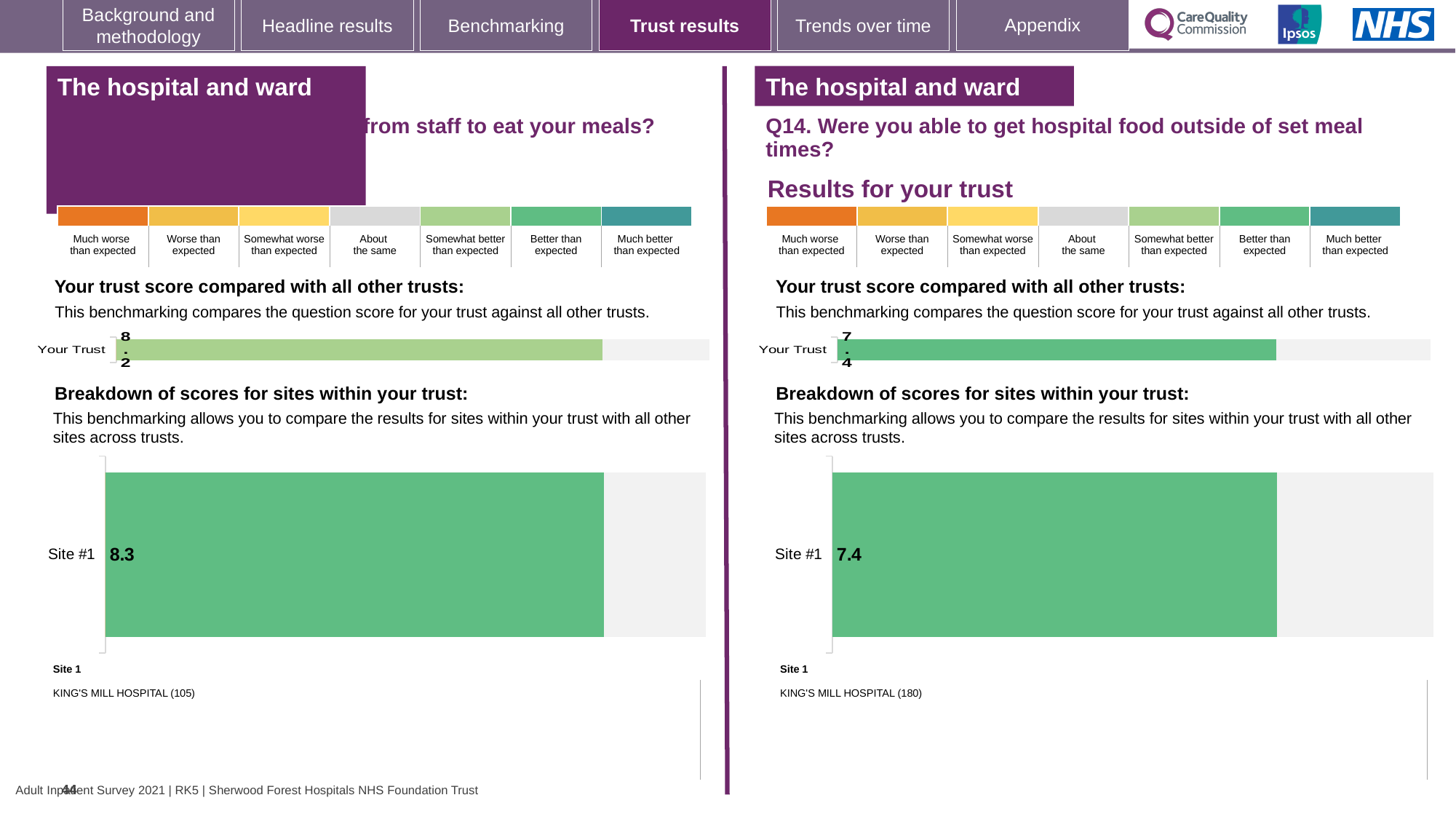
Which is larger: the Your Trust score on the left-hand chart or the Your Trust score on the right-hand Q14 chart? The left-hand chart (8.2) On the right-hand Q14 breakdown of scores for sites chart, what is the score for Site #1? 7.4 What kind of chart is used to show the Your Trust score on the right-hand Q14 section? Bar chart Which benchmark category does the colour of the Your Trust bar on the left-hand chart correspond to? Somewhat better than expected What is the difference between the Site #1 score on the left-hand chart and the Site #1 score on the right-hand Q14 chart? 0.9 On the left-hand side, what is the difference between the Site #1 score and the Your Trust score? 0.1 On the right-hand chart for Q14, what is the score shown for Your Trust? 7.4 Which benchmark category does the colour of the Your Trust bar on the right-hand Q14 chart correspond to? Better than expected On the left-hand chart, what is the score shown for Your Trust? 8.2 On the right-hand Q14 breakdown chart, which hospital is Site 1? KING'S MILL HOSPITAL (180) How many sites are shown in the right-hand Q14 breakdown of scores for sites chart? 1 On the left-hand breakdown of scores for sites chart, what is the score for Site #1? 8.3